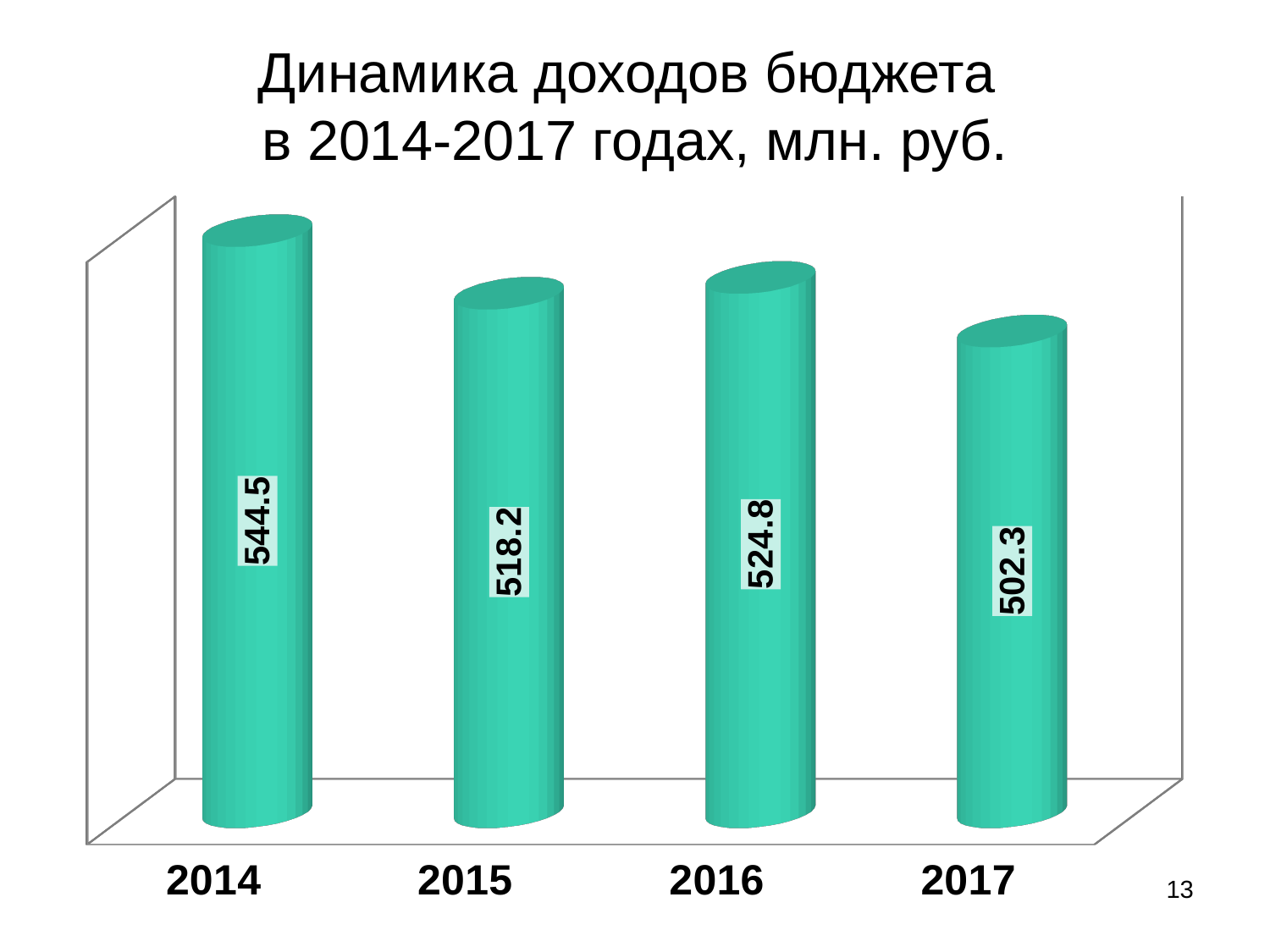
What is the difference between the budget revenue in 2014 and 2017? 42.2 What is the difference between the budget revenue in 2016 and 2015? 6.6 What is the budget revenue value for 2014? 544.5 Which year has the lowest budget revenue? 2017 Which year has the highest budget revenue? 2014 What is the budget revenue value for 2015? 518.2 Which year has the larger budget revenue, 2015 or 2016? 2016 How many years are shown on the chart? 4 What kind of chart is shown on the slide? Bar chart What is the budget revenue value for 2016? 524.8 What is the budget revenue value for 2017? 502.3 What is the title of the chart? Динамика доходов бюджета в 2014-2017 годах, млн. руб.